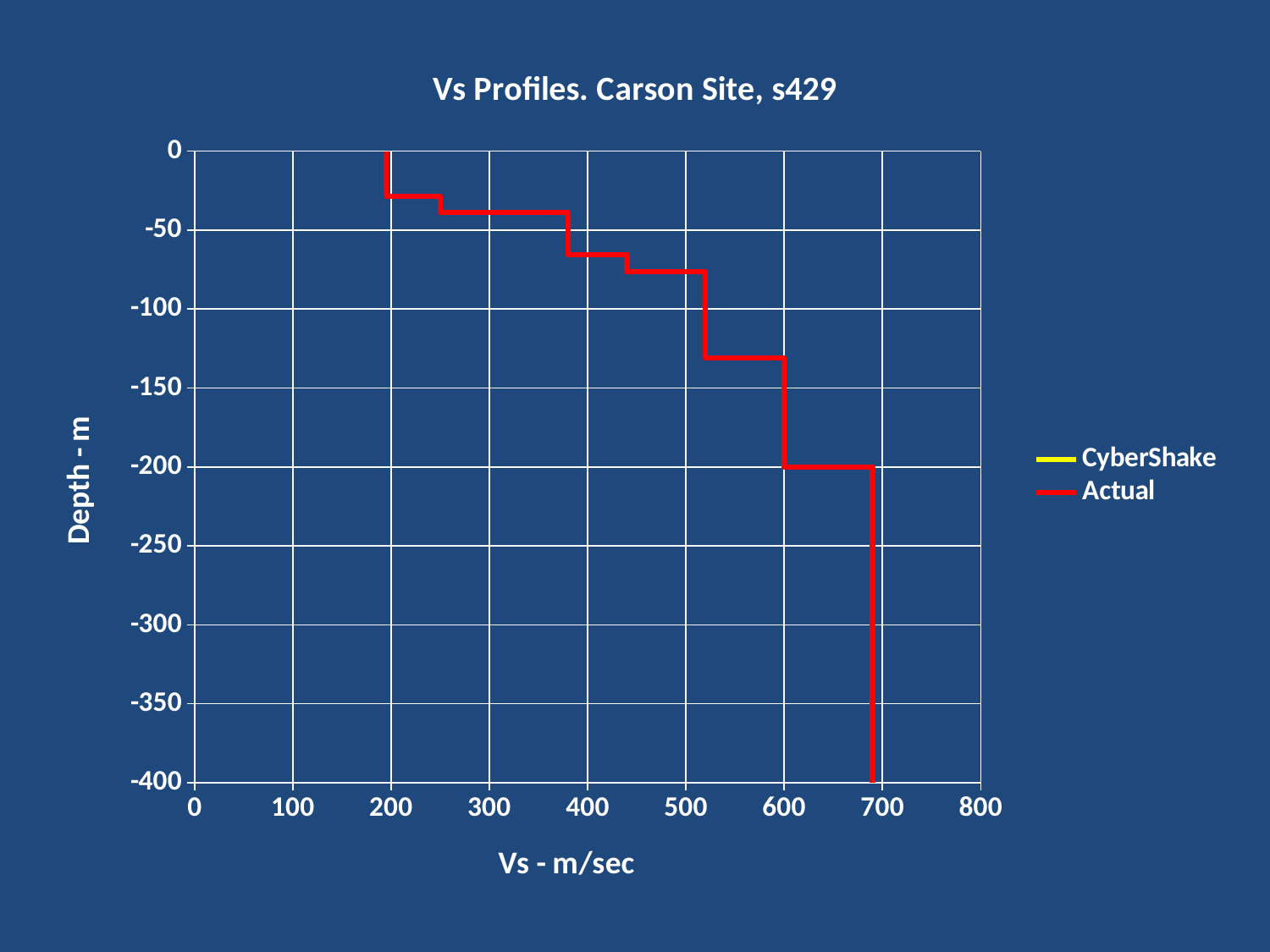
What is the title of the chart? Vs Profiles. Carson Site, s429 What is the label of the horizontal axis? Vs - m/sec How many series does the chart legend list? 2 Which series is drawn in red according to the legend? Actual Is the Actual Vs value at a depth of -10 m greater or less than 300? less Does the Actual Vs value increase or decrease as depth goes from 0 m down to -400 m? increase Is the Actual Vs value at a depth of -170 m greater or less than 500? greater Is the Actual Vs value at a depth of -100 m greater or less than 500? greater What kind of chart is shown on the slide? line chart Which is larger for the Actual profile: the Vs value at a depth of -350 m or at a depth of -50 m? -350 m